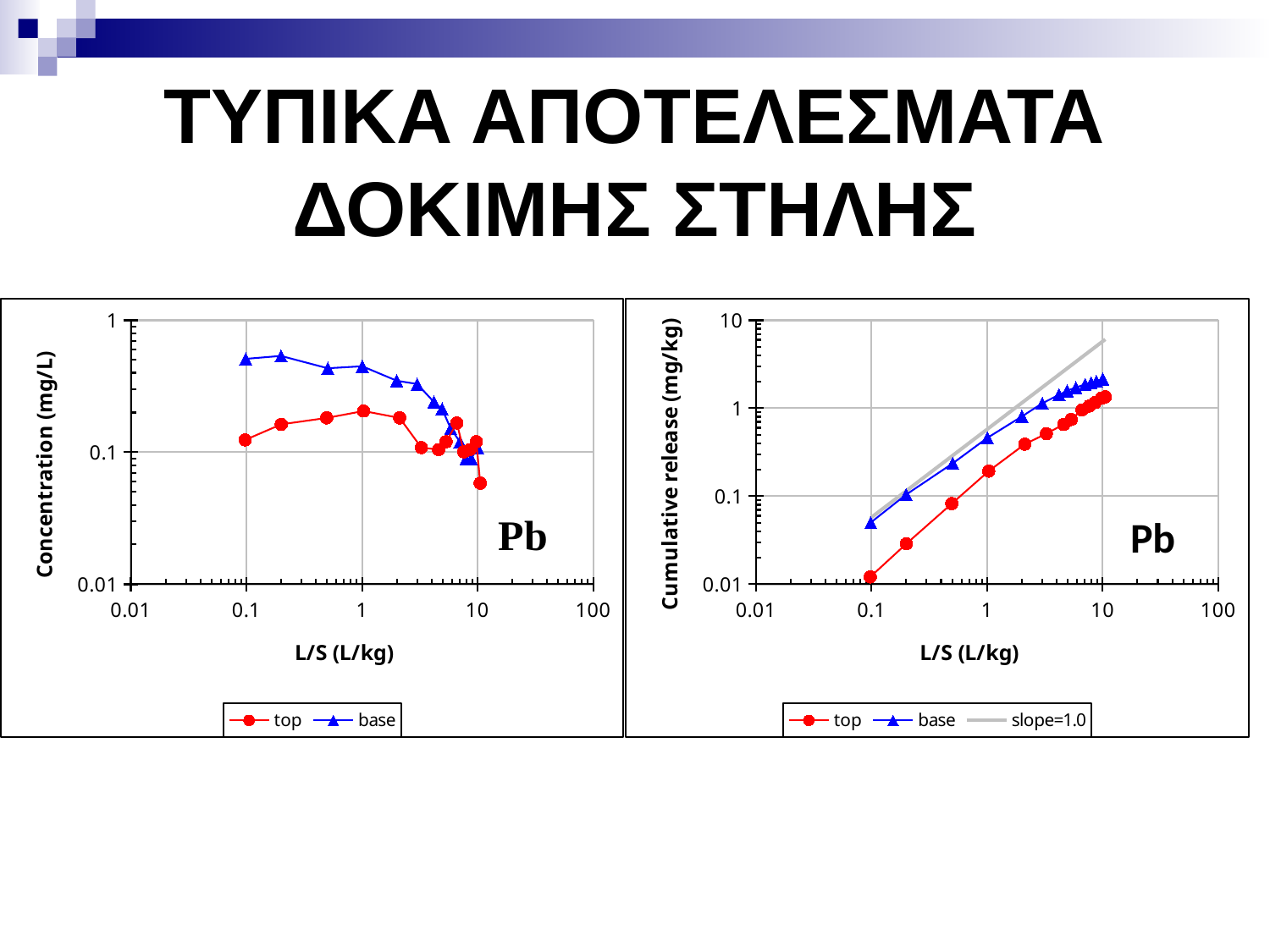
What is the y-axis title of the left chart? Concentration (mg/L) In the right chart (Cumulative release vs L/S), is the 'base' value at L/S = 10 greater or less than 1 mg/kg? greater In the left chart (Concentration vs L/S), how many series does the legend list? 2 In the right chart (Cumulative release vs L/S), how many series does the legend list? 3 What kind of chart is the right chart (Cumulative release vs L/S)? line chart In the left chart (Concentration vs L/S), at L/S = 1, which series has the higher concentration, 'top' or 'base'? base In the right chart (Cumulative release vs L/S), is the 'base' value at L/S = 0.1 greater or less than 0.1 mg/kg? less In the right chart (Cumulative release vs L/S), what are the legend entries? top, base, slope=1.0 In the right chart (Cumulative release vs L/S), does the 'top' series rise or fall as L/S increases? rise In the right chart (Cumulative release vs L/S), does the 'base' series rise or fall as L/S increases? rise In the left chart (Concentration vs L/S), does the 'base' series overall rise or fall as L/S increases? fall In the left chart (Concentration vs L/S), is the 'base' value at L/S = 0.1 greater or less than 0.1 mg/L? greater